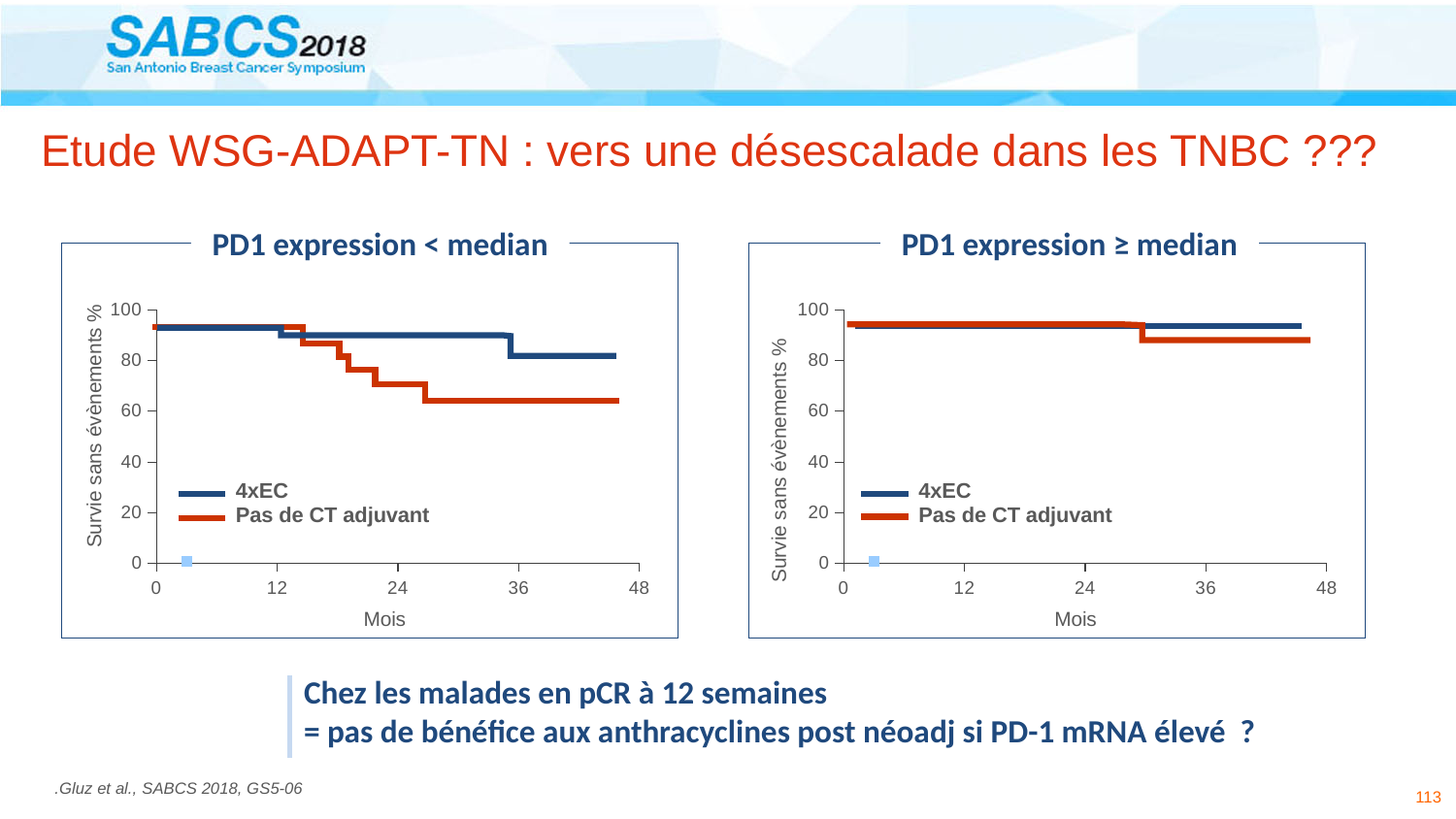
In the 'PD1 expression < median' chart, which series is higher at 36 months, '4xEC' or 'Pas de CT adjuvant'? 4xEC In the 'PD1 expression < median' chart, does the 'Pas de CT adjuvant' series rise or fall as months increase? fall In the 'PD1 expression < median' chart, is the value for '4xEC' at 24 months greater or less than 80? greater In the 'PD1 expression < median' chart, is the value for 'Pas de CT adjuvant' at 36 months greater or less than 80? less How many series does the legend of the 'PD1 expression ≥ median' chart list? 2 In the 'PD1 expression < median' chart, what is the label of the x axis? Mois In the 'PD1 expression < median' chart, what are the two series named in the legend? 4xEC and Pas de CT adjuvant What kind of chart is the 'PD1 expression < median' chart? line chart In the 'PD1 expression < median' chart, is the value for 'Pas de CT adjuvant' at 24 months greater or less than 60? greater What is the highest tick value shown on the x axis of the 'PD1 expression ≥ median' chart? 48